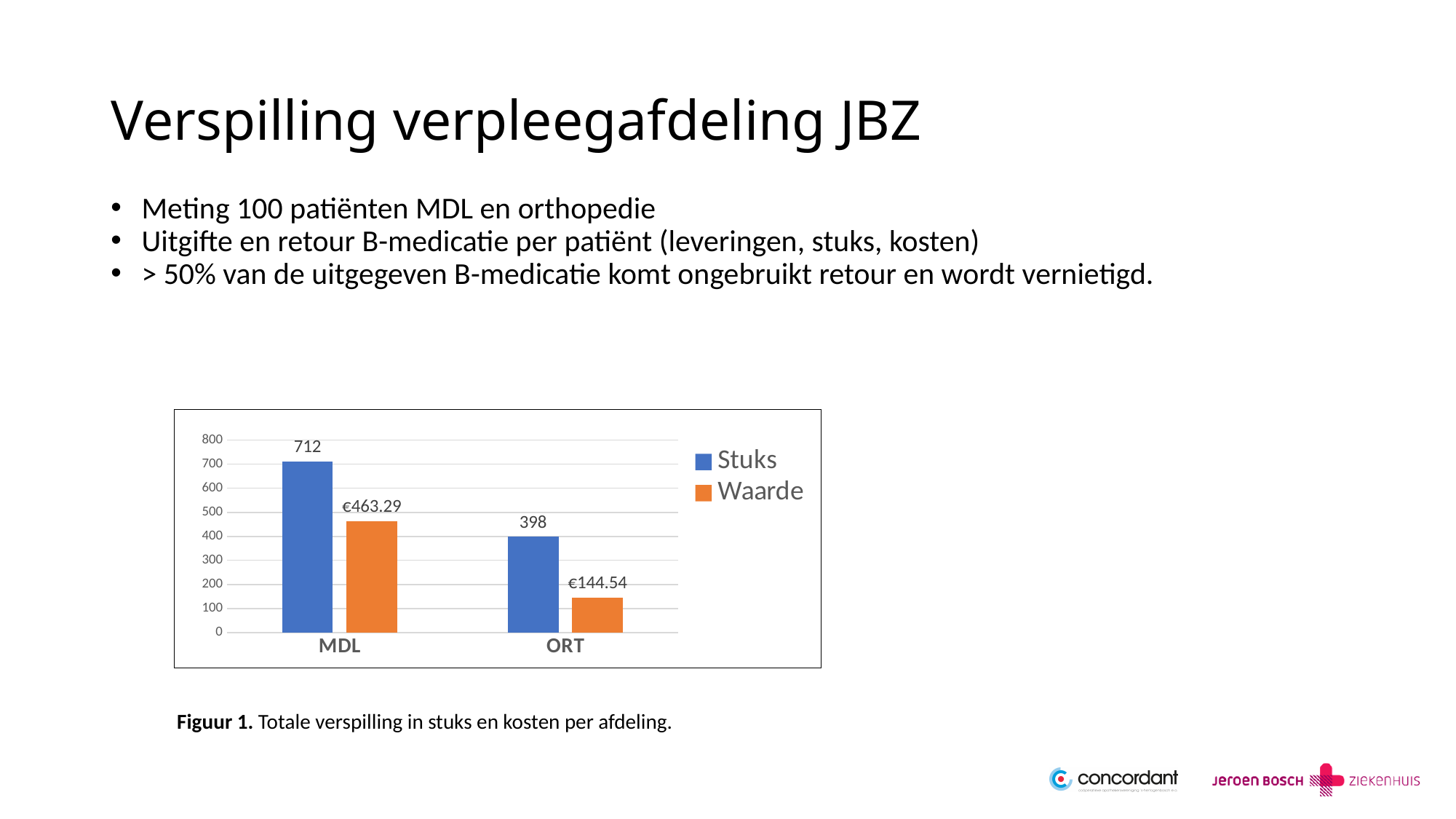
How many categories are shown on the x axis? 2 How many series does the legend list? 2 What kind of chart is shown on the slide? Bar chart Which category has the highest Stuks value? MDL What is the Stuks value for ORT? 398 What is the Waarde value for MDL? €463.29 What is the Waarde value for ORT? €144.54 What is the Stuks value for MDL? 712 Which category has the lowest Waarde value? ORT What is the difference in Stuks between MDL and ORT? 314 Which is larger: the Stuks value for ORT or the Waarde value for MDL? Waarde value for MDL Which colour represents the Waarde series in the legend? Orange